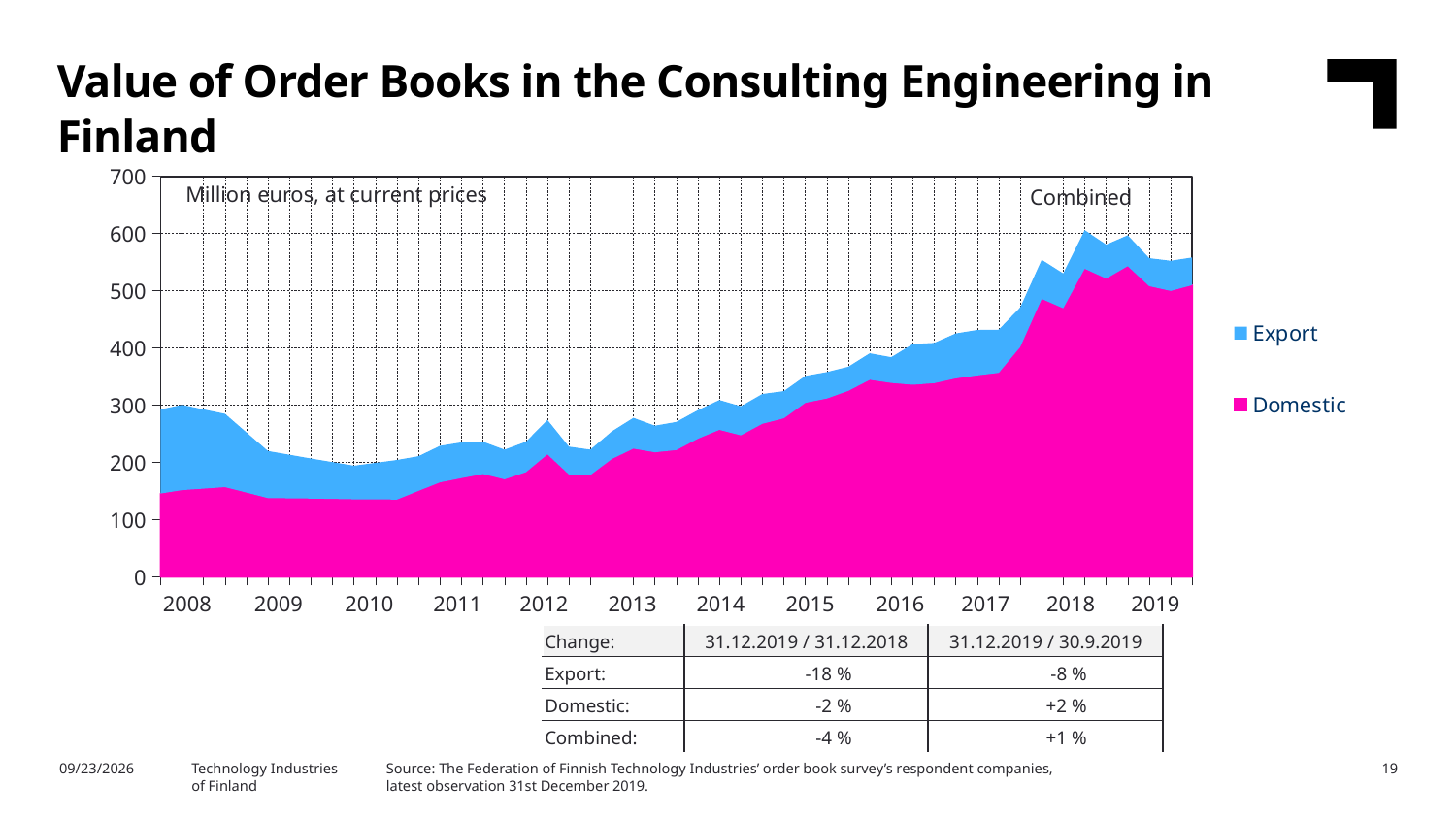
Does the combined value of order books generally rise or fall from 2008 to 2019? Rise How many years are labeled on the x axis of the chart? 12 What are the two series named in the chart legend? Export and Domestic Is the combined value at its 2018 peak greater or less than 500? greater Is the combined value during 2010 greater or less than 300? less Is the combined value at the start of 2008 greater or less than 200? greater What kind of chart is shown on the slide? Area chart At the end of 2019, which is larger: the Domestic value or the Export value? Domestic How many series does the chart legend list? 2 In what unit are the values on the chart expressed, according to the label inside the plot area? Million euros, at current prices